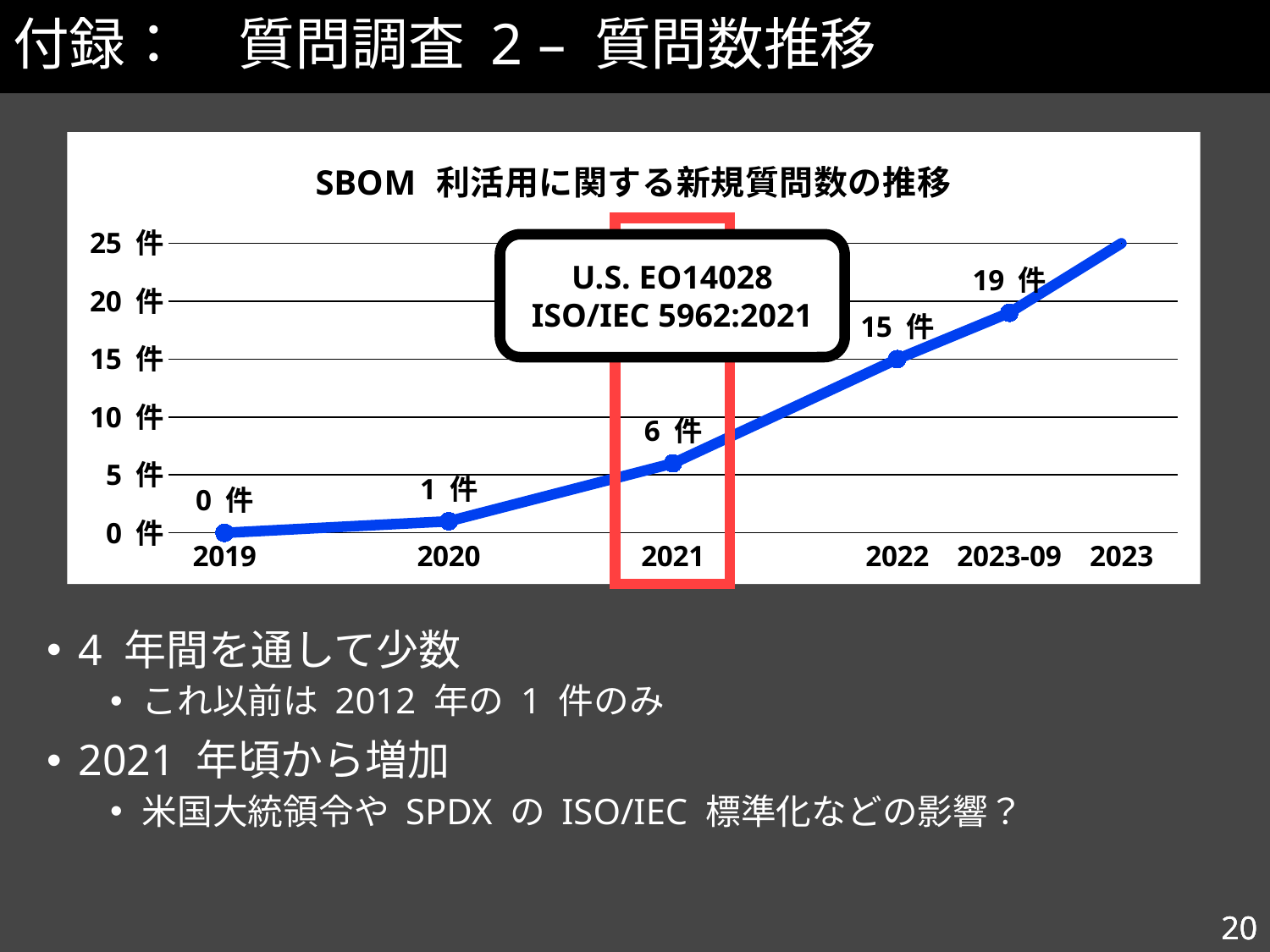
Which is larger, the value for 2022 or the value for 2020? 2022 What is the value for 2019 in the chart? 0 件 What is the value for 2023-09 in the chart? 19 件 Which year has the lowest value in the chart? 2019 What is the value for 2022 in the chart? 15 件 What is the value for 2020 in the chart? 1 件 What is the value for 2021 in the chart? 6 件 What is the difference between the values for 2022 and 2021? 9 件 What kind of chart is shown on the slide? Line chart Is the value for 2023 greater or less than 20 件? greater Which x-axis category has the highest value in the chart? 2023 How many data points are plotted on the line? 6